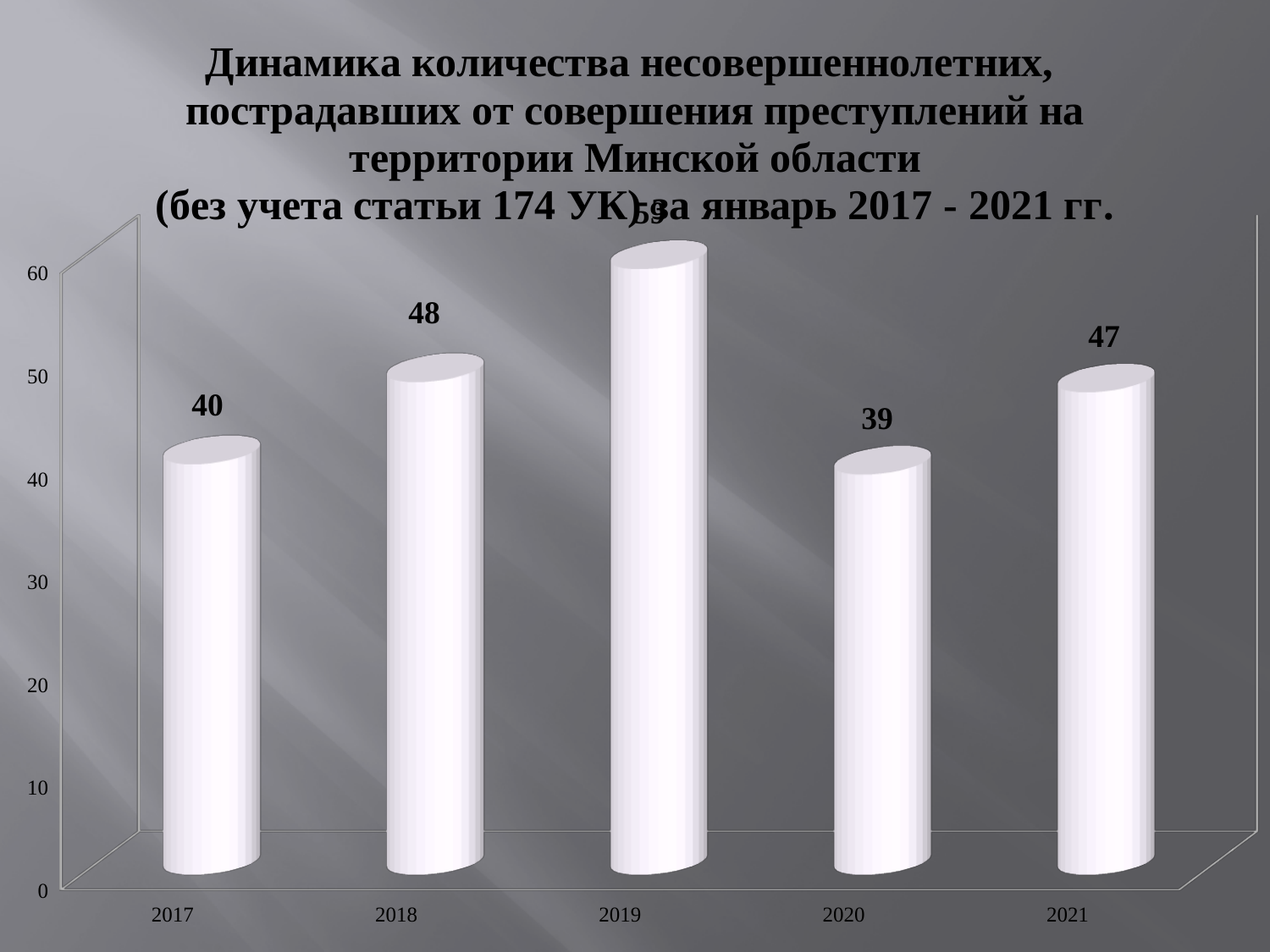
What is the value for 2017? 40 What is the value for 2018? 48 What is the value for 2020? 39 Which year has the lowest value? 2020 Which is larger, the value for 2021 or the value for 2020? 2021 What is the difference between the values for 2018 and 2017? 8 What is the value for 2021? 47 What kind of chart is this? bar chart Is the value for 2019 greater or less than 50? greater Does the value rise or fall from 2019 to 2020? fall How many years are shown on the x axis? 5 Which year has the highest value? 2019